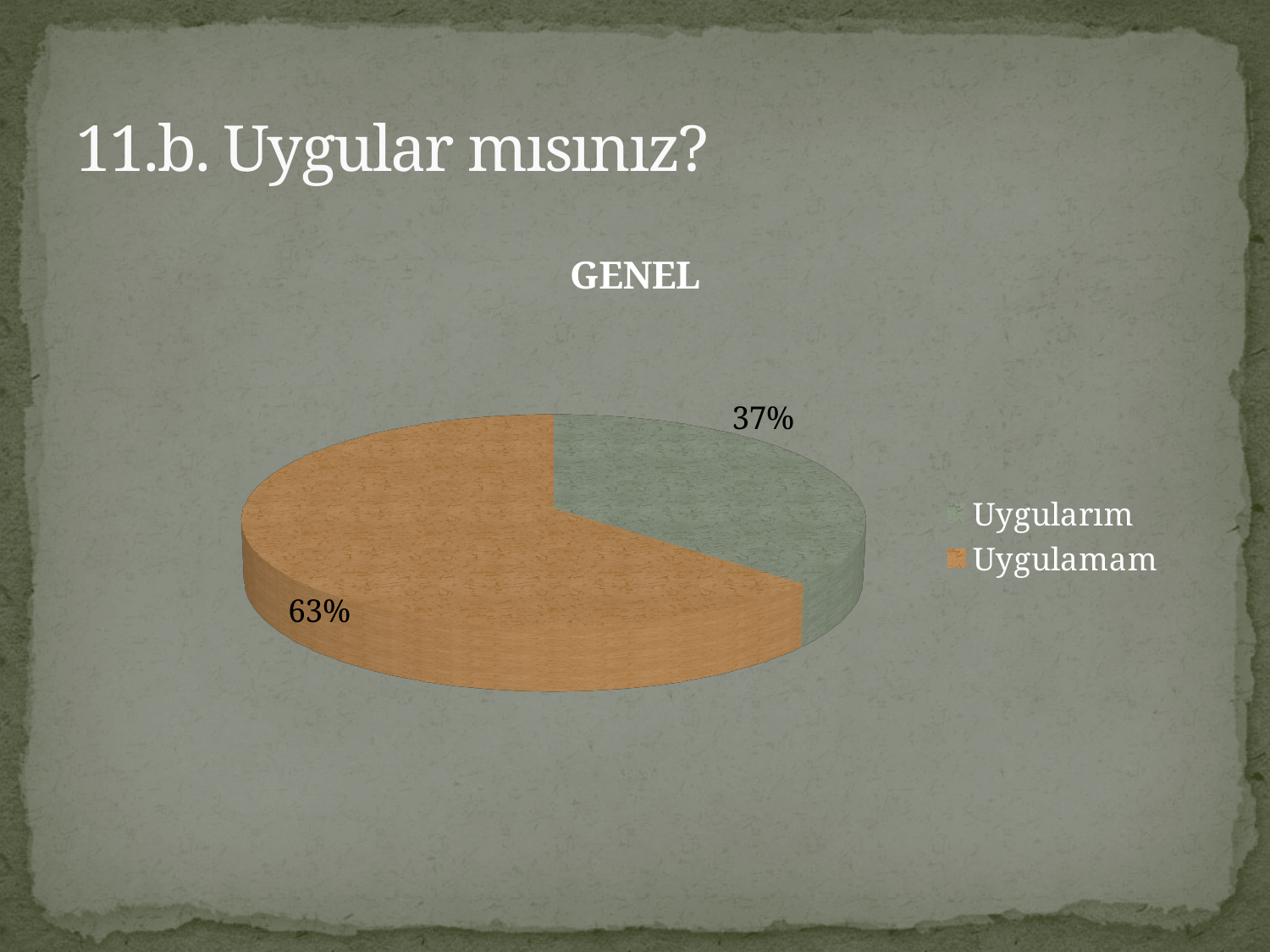
What share of the pie does "Uygularım" take? 37% What share of the pie does "Uygulamam" take? 63% Which category has the smallest slice of the pie? Uygularım What is the difference in percentage points between "Uygulamam" and "Uygularım"? 26 Which is larger, the slice for "Uygularım" or the slice for "Uygulamam"? Uygulamam How many entries does the legend list? 2 Which category has the largest slice of the pie? Uygulamam What is the title of the chart? GENEL Which colour represents "Uygulamam" in the chart? orange How many categories does the pie chart have? 2 What kind of chart is shown on the slide? pie chart